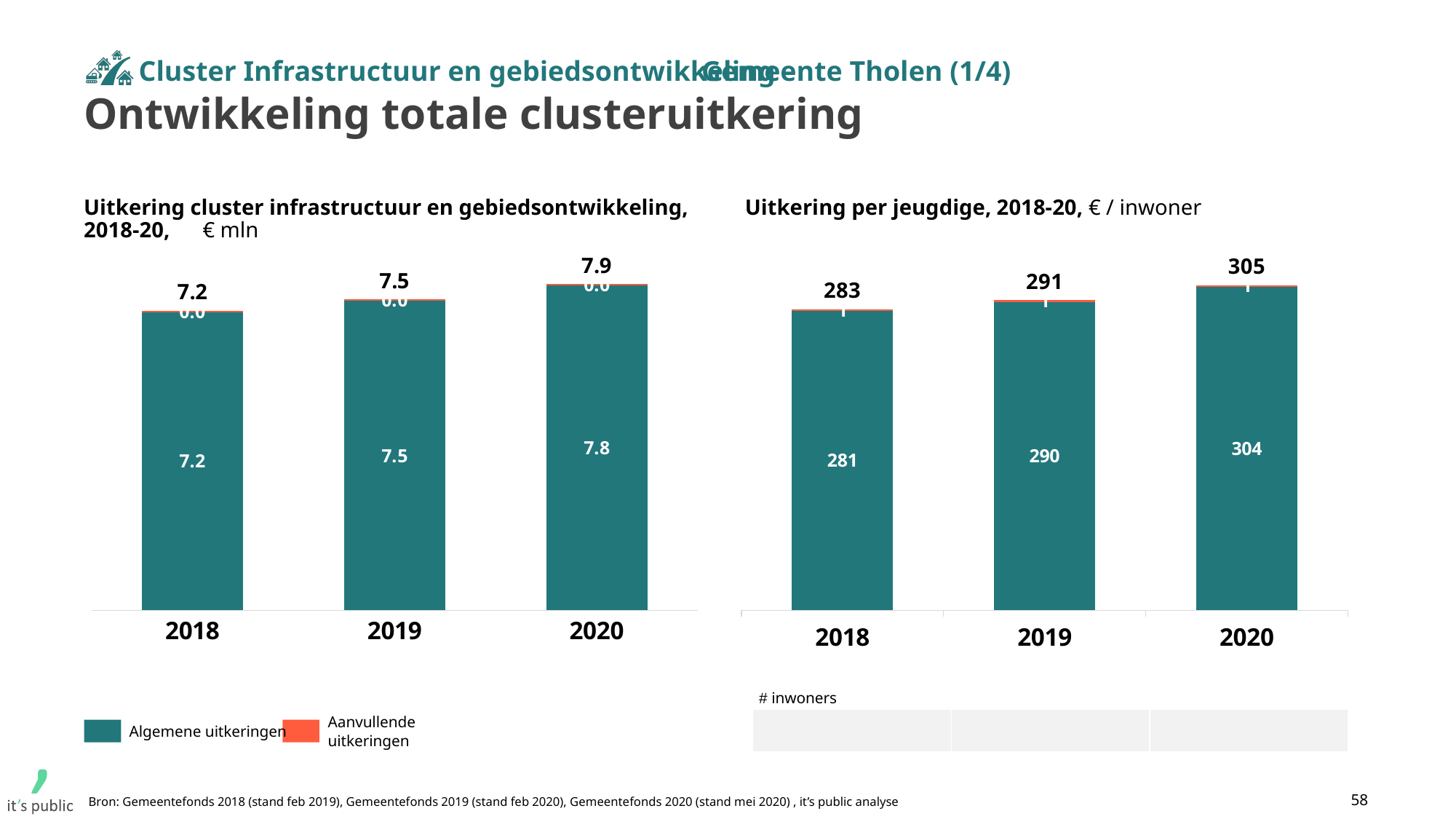
In the right chart (Uitkering per jeugdige), what is the Algemene uitkeringen value for 2020? 304 In the left chart (Uitkering cluster infrastructuur en gebiedsontwikkeling), what is the Algemene uitkeringen value for 2020? 7.8 In the right chart (Uitkering per jeugdige), what is the Algemene uitkeringen value for 2018? 281 In the left chart (Uitkering cluster infrastructuur en gebiedsontwikkeling), what is the total value shown above the bar for 2020? 7.9 In the right chart (Uitkering per jeugdige), what is the total value shown above the bar for 2019? 291 How many series does the legend on the slide list? 2 In the left chart (Uitkering cluster infrastructuur en gebiedsontwikkeling), what is the Algemene uitkeringen value for 2019? 7.5 In the right chart (Uitkering per jeugdige), what is the difference between the 2020 total and the 2018 total? 22 In the left chart (Uitkering cluster infrastructuur en gebiedsontwikkeling), what is the difference between the 2020 total and the 2018 total? 0.7 In the right chart (Uitkering per jeugdige), which year has the highest total? 2020 In the left chart (Uitkering cluster infrastructuur en gebiedsontwikkeling), which year has the lowest total? 2018 In the right chart (Uitkering per jeugdige), do the totals rise or fall from 2018 to 2020? rise